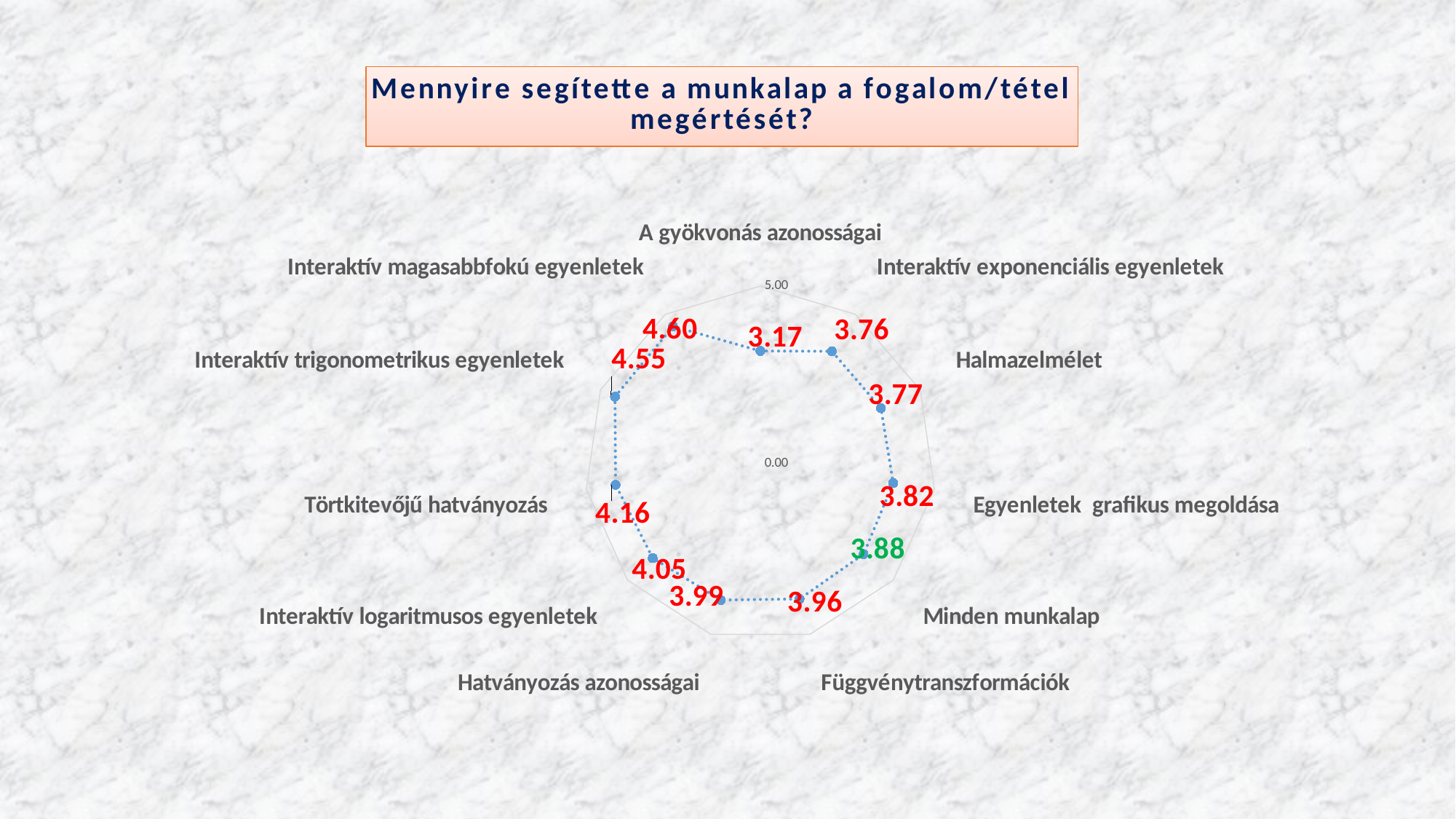
Which is larger, the value for Törtkitevőjű hatványozás or the value for Egyenletek grafikus megoldása? Törtkitevőjű hatványozás What is the value for Halmazelmélet? 3.77 What is the value for Interaktív magasabbfokú egyenletek? 4.60 Which category has the highest value? Interaktív magasabbfokú egyenletek What type of chart is shown on the slide? radar chart What is the difference between the values for Interaktív magasabbfokú egyenletek and A gyökvonás azonosságai? 1.43 What is the title shown above the chart? Mennyire segítette a munkalap a fogalom/tétel megértését? How many categories does the radar chart have? 11 What is the value for Minden munkalap? 3.88 What is the maximum value shown on the chart's axis? 5.00 What is the value for A gyökvonás azonosságai? 3.17 Which category has the lowest value? A gyökvonás azonosságai